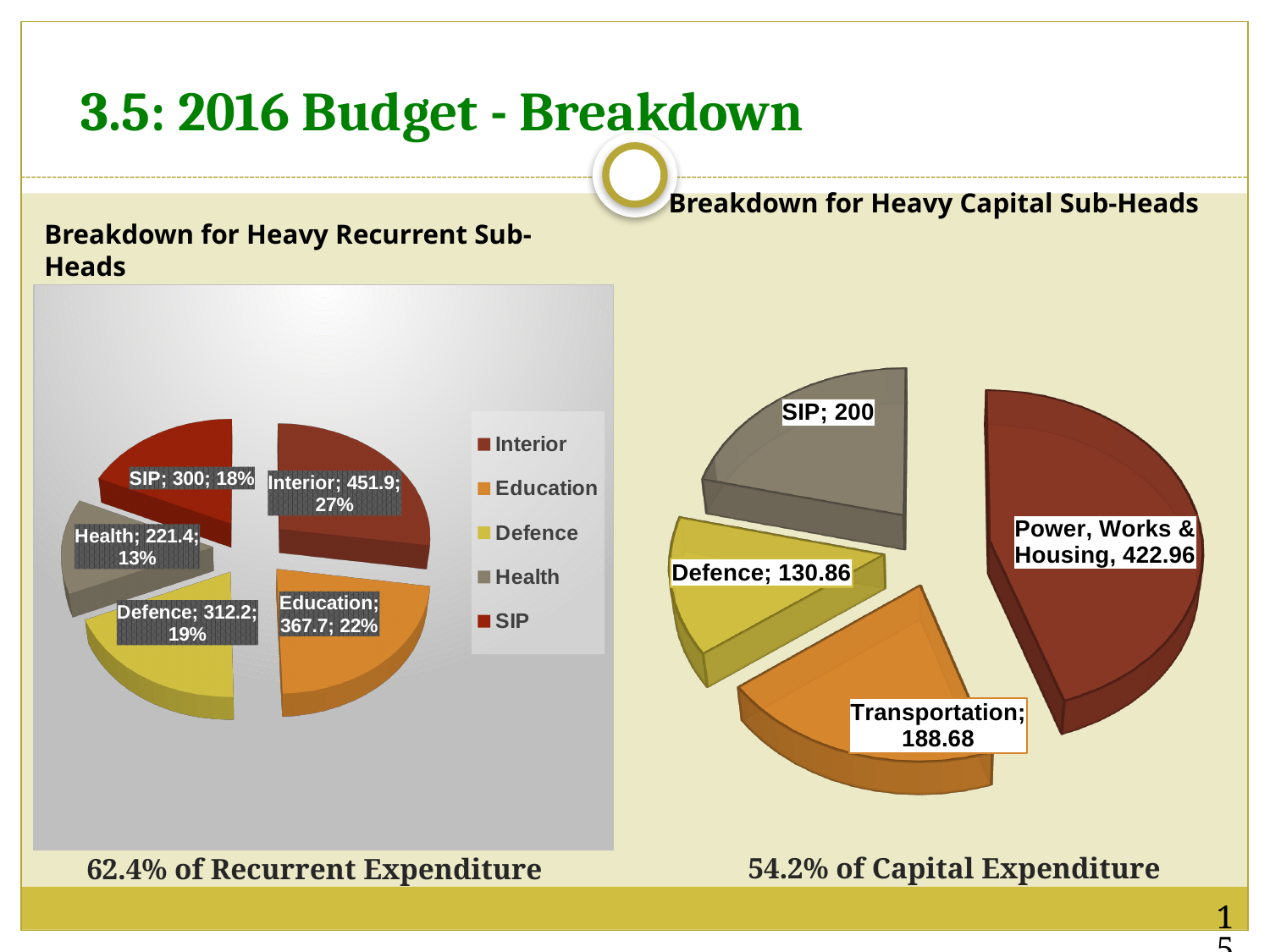
How many slices does the 'Breakdown for Heavy Capital Sub-Heads' pie chart have? 4 In the 'Breakdown for Heavy Recurrent Sub-Heads' chart, what is the difference between the values for Defence and SIP? 12.2 In the 'Breakdown for Heavy Recurrent Sub-Heads' chart, what percentage share does Education have? 22% In the 'Breakdown for Heavy Recurrent Sub-Heads' chart, which category has the largest value? Interior In the 'Breakdown for Heavy Capital Sub-Heads' chart, what is the value for Transportation? 188.68 In the 'Breakdown for Heavy Recurrent Sub-Heads' chart, what is the value for Interior? 451.9 In the 'Breakdown for Heavy Capital Sub-Heads' chart, which category has the largest value? Power, Works & Housing What type of chart is the 'Breakdown for Heavy Recurrent Sub-Heads' chart? Pie chart In the 'Breakdown for Heavy Recurrent Sub-Heads' chart, which category has the smallest value? Health In the 'Breakdown for Heavy Capital Sub-Heads' chart, which category has the smallest value? Defence In the 'Breakdown for Heavy Capital Sub-Heads' chart, which is larger: SIP or Transportation? SIP How many categories does the legend of the 'Breakdown for Heavy Recurrent Sub-Heads' chart list? 5